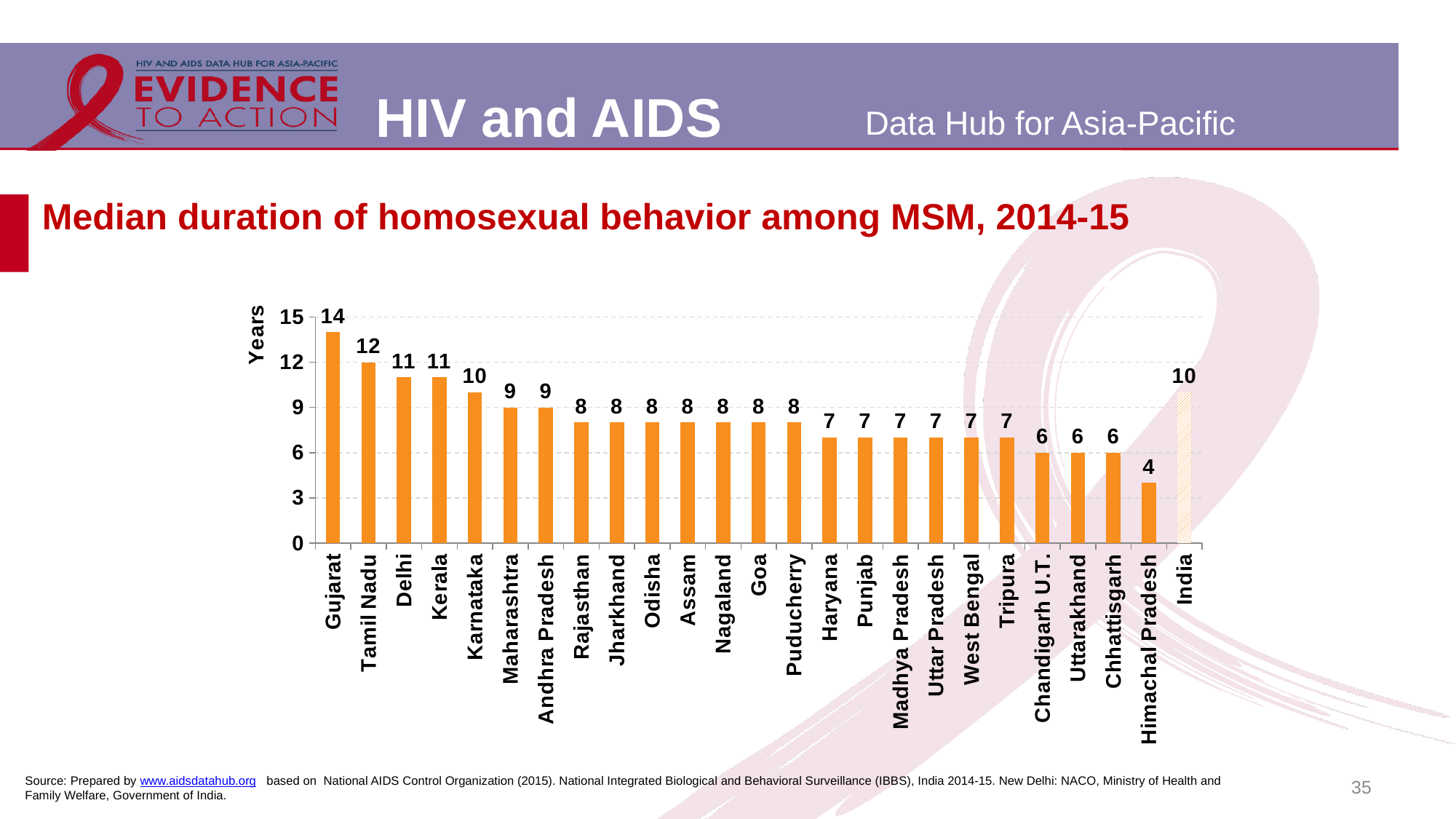
What is the difference between the values for Gujarat and Himachal Pradesh? 10 How many categories are shown on the x axis? 25 What is the title of the chart? Median duration of homosexual behavior among MSM, 2014-15 Which state has the lowest median duration? Himachal Pradesh What is the value shown for India? 10 Which state has the highest median duration? Gujarat What is the value shown for Himachal Pradesh? 4 What is the median duration of homosexual behavior among MSM in Gujarat? 14 Which has a larger value, Karnataka or Tripura? Karnataka What kind of chart is shown on the slide? Bar chart What is the value shown for Tamil Nadu? 12 What is the label of the y axis? Years